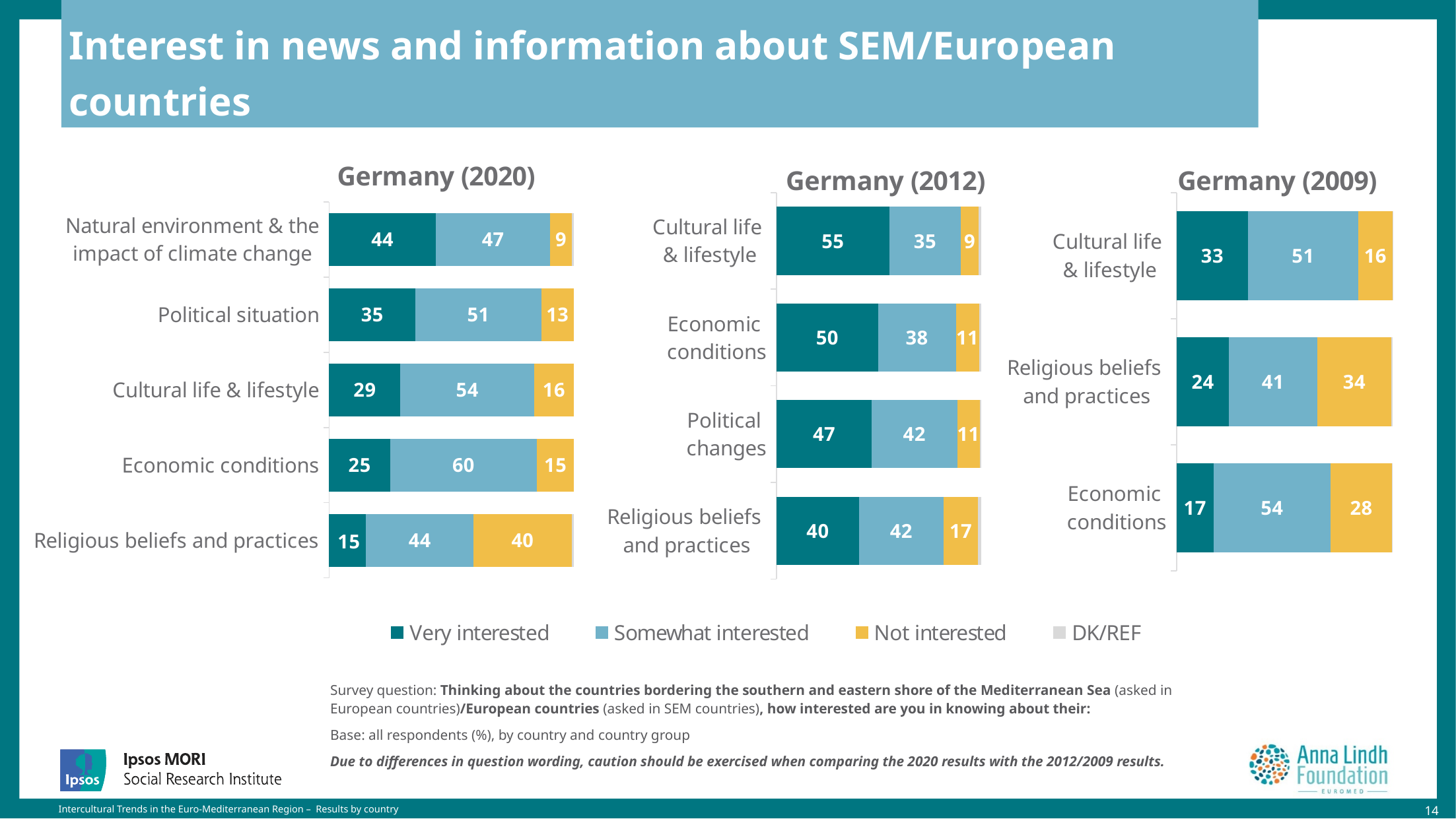
How many series does the legend list? 4 What kind of chart is the Germany (2012) chart? Stacked bar chart In the Germany (2012) chart, what is the 'Somewhat interested' value for economic conditions? 38 In the Germany (2009) chart, what is the 'Very interested' value for cultural life & lifestyle? 33 How many categories are shown in the Germany (2020) chart? 5 In the Germany (2020) chart, which category has the highest 'Very interested' value? Natural environment & the impact of climate change In the Germany (2009) chart, what is the total of the three labelled segments for religious beliefs and practices? 99 In the Germany (2012) chart, what is the difference between the 'Very interested' values for cultural life & lifestyle and religious beliefs and practices? 15 In the Germany (2020) chart, what is the 'Not interested' value for religious beliefs and practices? 40 In the Germany (2020) chart, which is larger: the 'Somewhat interested' value for economic conditions or for political situation? Economic conditions In the Germany (2009) chart, which category has the lowest 'Very interested' value? Economic conditions In the Germany (2020) chart, what percentage is 'Very interested' in the natural environment & the impact of climate change? 44